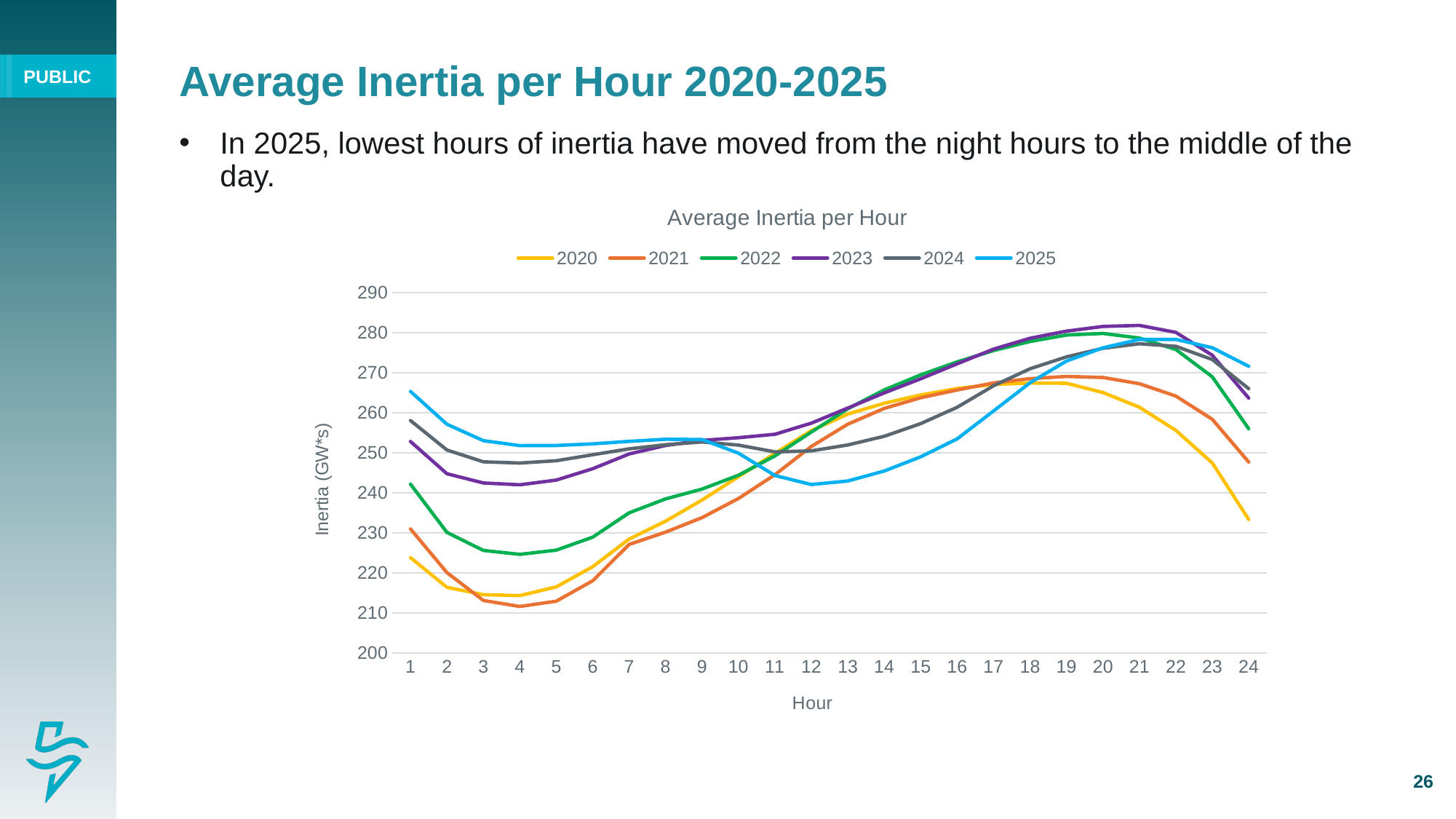
Is the value for 2020 at hour 24 greater or less than 240? less Which series has the highest value at hour 1? 2025 Is the value for 2025 at hour 1 greater or less than 260? greater What kind of chart is shown on the slide? line chart Is the value for 2025 at hour 12 greater or less than 250? less How many hours are plotted along the x axis? 24 How many series does the legend list? 6 Does the 2025 line rise or fall from hour 1 to hour 12? fall Which series has the lowest value at hour 24? 2020 At hour 12, which series has the larger value, 2023 or 2025? 2023